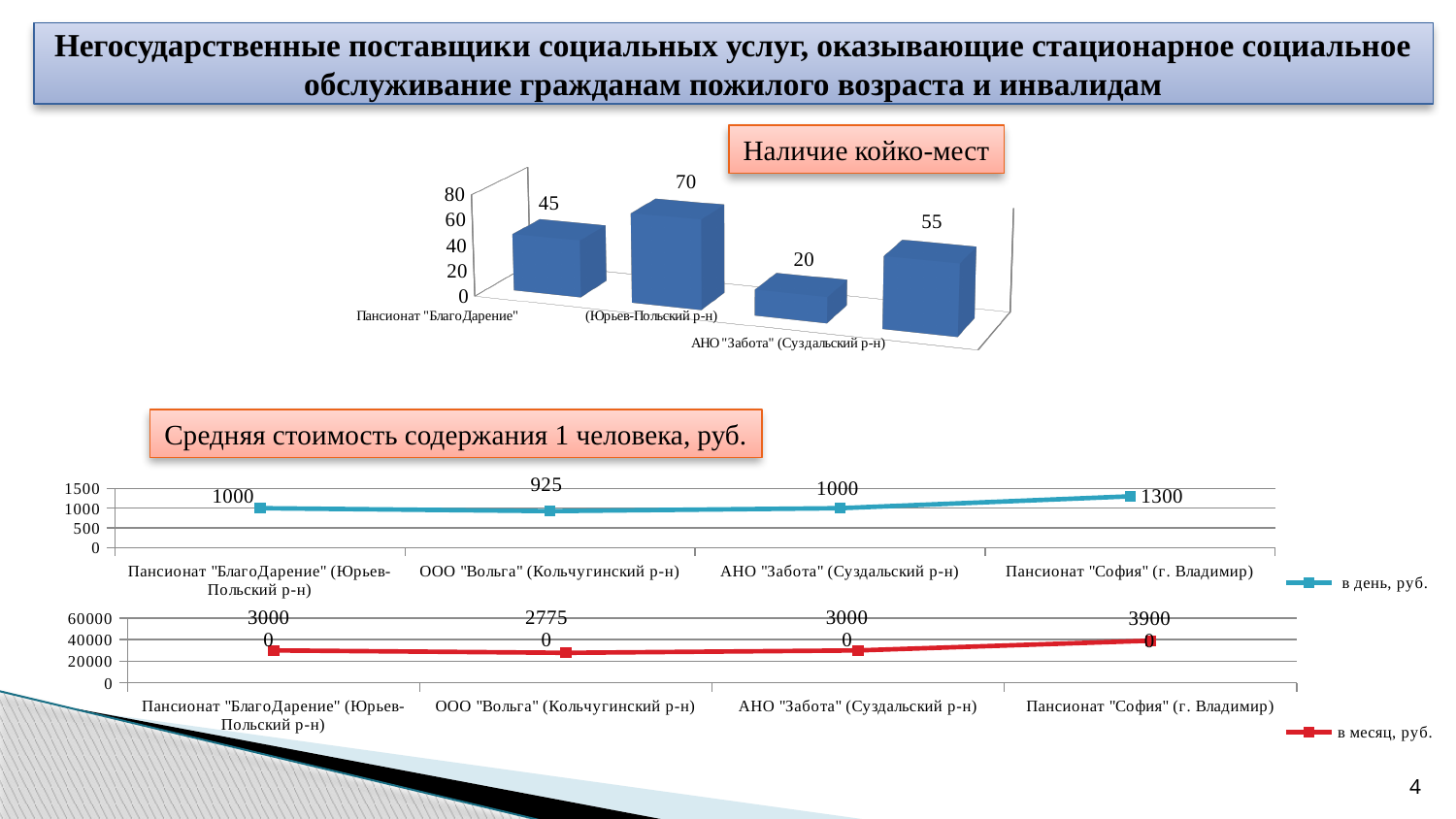
In the 'Наличие койко-мест' chart, how many bars are plotted? 4 In the 'Наличие койко-мест' chart, what is the highest value shown on any bar? 70 What kind of chart is the 'Наличие койко-мест' chart? bar chart In the 'Наличие койко-мест' chart, what is the value for Пансионат "БлагоДарение"? 45 In the 'в месяц, руб.' line chart, which is larger: the value for ООО "Вольга" (Кольчугинский р-н) or the value for АНО "Забота" (Суздальский р-н)? АНО "Забота" (Суздальский р-н) In the 'в день, руб.' line chart, what is the value for Пансионат "София" (г. Владимир)? 1300 In the 'в месяц, руб.' line chart, what is the value for Пансионат "София" (г. Владимир)? 39000 In the 'в день, руб.' line chart, which category has the lowest value? ООО "Вольга" (Кольчугинский р-н) In the 'в день, руб.' line chart, what is the value for ООО "Вольга" (Кольчугинский р-н)? 925 In the 'Наличие койко-мест' chart, what is the value for АНО "Забота" (Суздальский р-н)? 20 In the 'в день, руб.' line chart, what is the difference between the values for Пансионат "София" (г. Владимир) and АНО "Забота" (Суздальский р-н)? 300 What is the title of the bar chart at the top of the slide? Наличие койко-мест